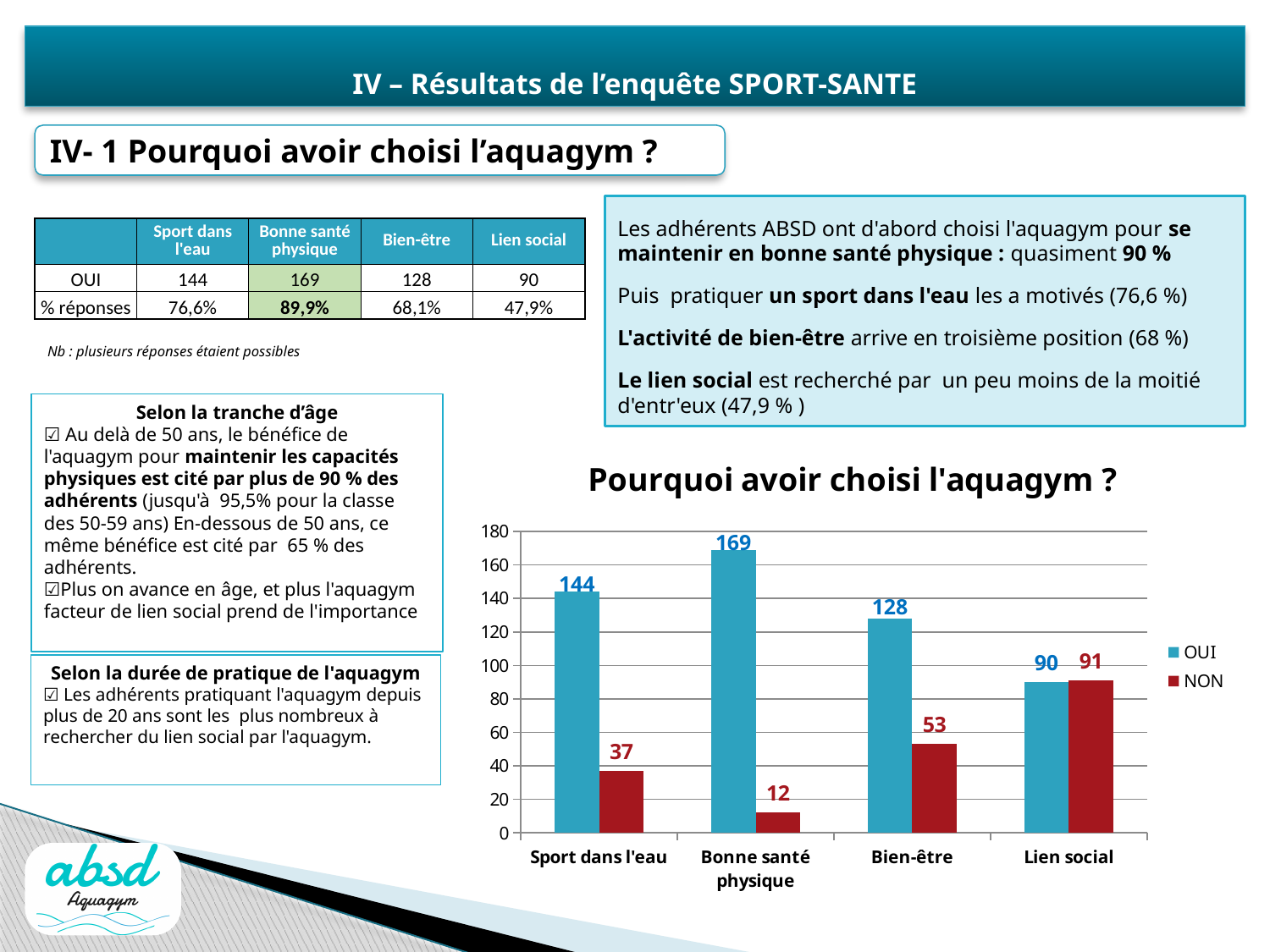
What is the title of the chart? Pourquoi avoir choisi l'aquagym ? How many categories are shown on the x axis of the chart? 4 What is the OUI value for Bonne santé physique? 169 Is the OUI value for Lien social greater or less than 100? less Which is larger, the OUI value for Sport dans l'eau or the OUI value for Bien-être? Sport dans l'eau What is the NON value for Lien social? 91 What is the NON value for Sport dans l'eau? 37 What kind of chart is shown on the slide? bar chart What is the difference between the OUI and NON values for Bien-être? 75 How many series does the chart legend list? 2 Which category has the lowest NON value? Bonne santé physique Which category has the highest OUI value? Bonne santé physique